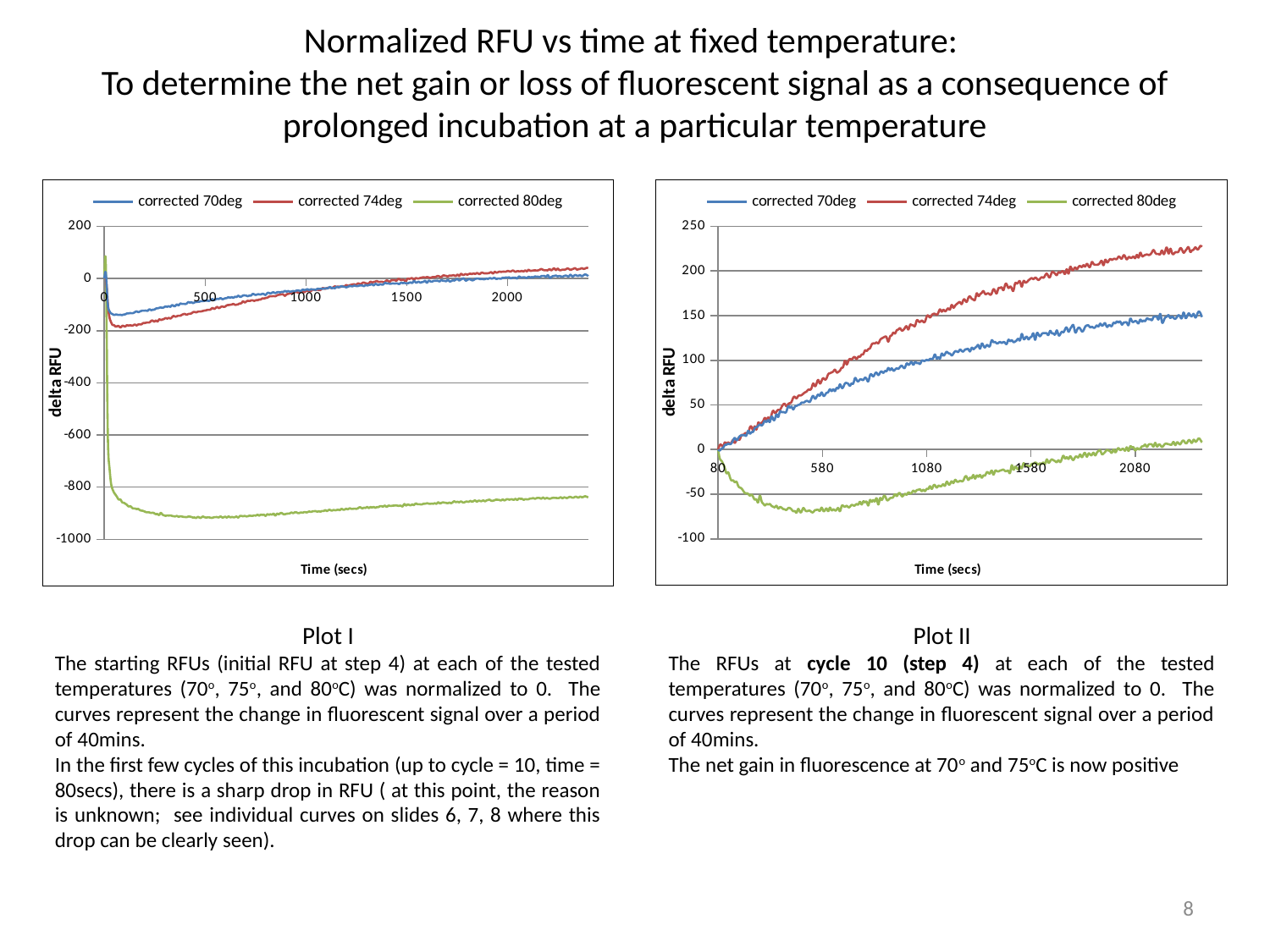
What kind of chart is Plot I (the left chart)? line chart How many series does the legend of Plot II (the right chart) list? 3 In Plot II (the right chart), does the corrected 74deg series rise or fall as time increases? rise In Plot I (the left chart), which series has the lowest values across the time range? corrected 80deg In Plot I (the left chart), at time 1500, which is larger: corrected 70deg or corrected 80deg? corrected 70deg In Plot II (the right chart), at time 2080, which is larger: corrected 74deg or corrected 70deg? corrected 74deg In Plot II (the right chart), is the value for corrected 74deg at time 2080 greater or less than 200? greater In Plot II (the right chart), is the value for corrected 80deg at time 580 greater or less than -50? less What is the y-axis title of Plot II (the right chart)? delta RFU In Plot I (the left chart), is the value for corrected 80deg at time 1000 greater or less than -600? less What is the x-axis title of Plot I (the left chart)? Time (secs) In Plot II (the right chart), which series reaches the highest value at the end of the time range? corrected 74deg